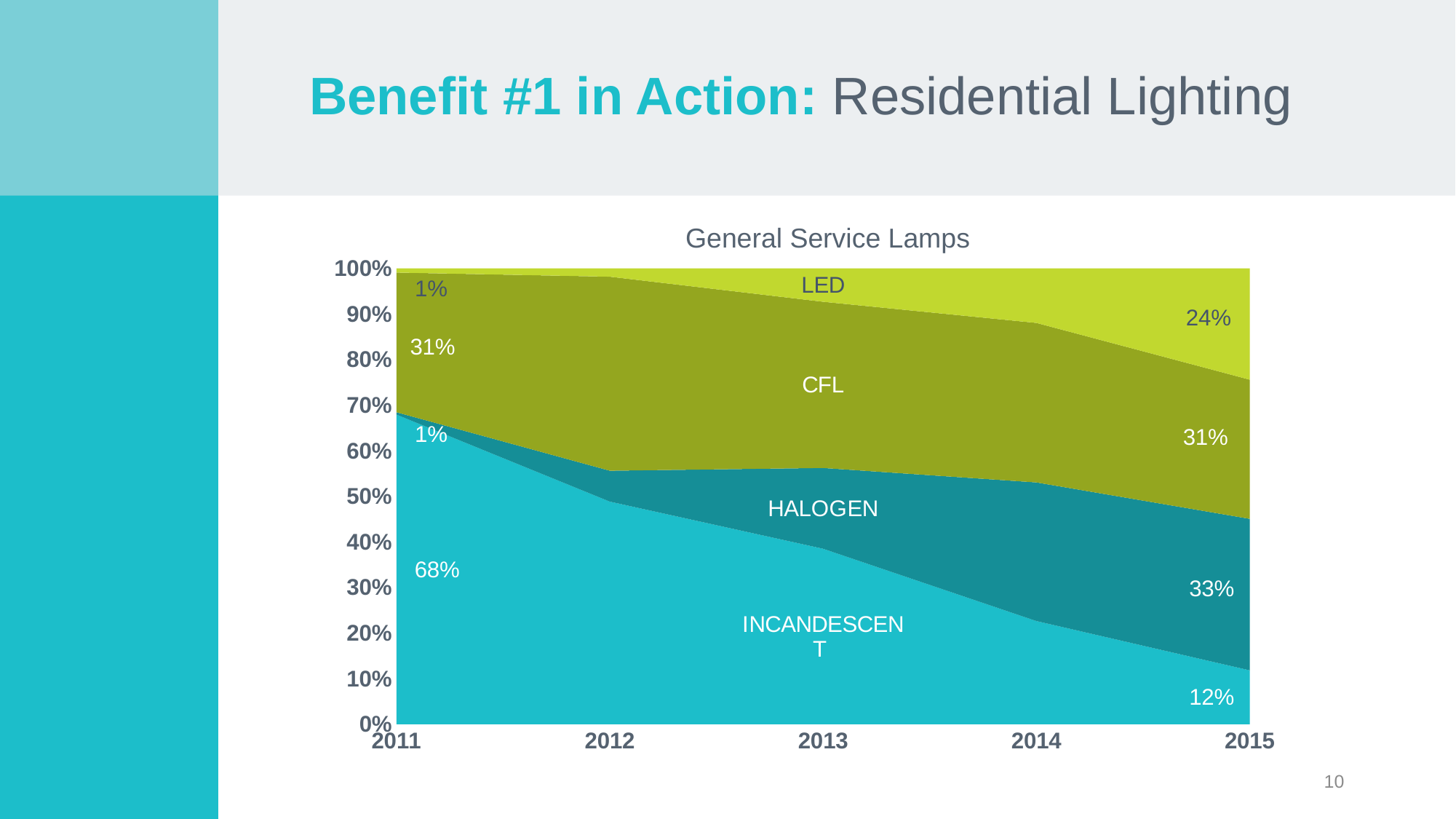
Does the INCANDESCENT share rise or fall from 2011 to 2015? fall What type of chart is shown on the slide? stacked area chart What share did CFL lamps have in 2015? 31% What share did INCANDESCENT lamps have in 2011? 68% Which lamp type had the smallest share in 2015? INCANDESCENT Which lamp type had the largest share in 2015? HALOGEN By how many percentage points did the INCANDESCENT share fall from 2011 to 2015? 56 How many years are shown on the x axis? 5 What share did HALOGEN lamps have in 2011? 1% What share did INCANDESCENT lamps have in 2015? 12% What share did LED lamps have in 2015? 24% What is the title of the chart? General Service Lamps